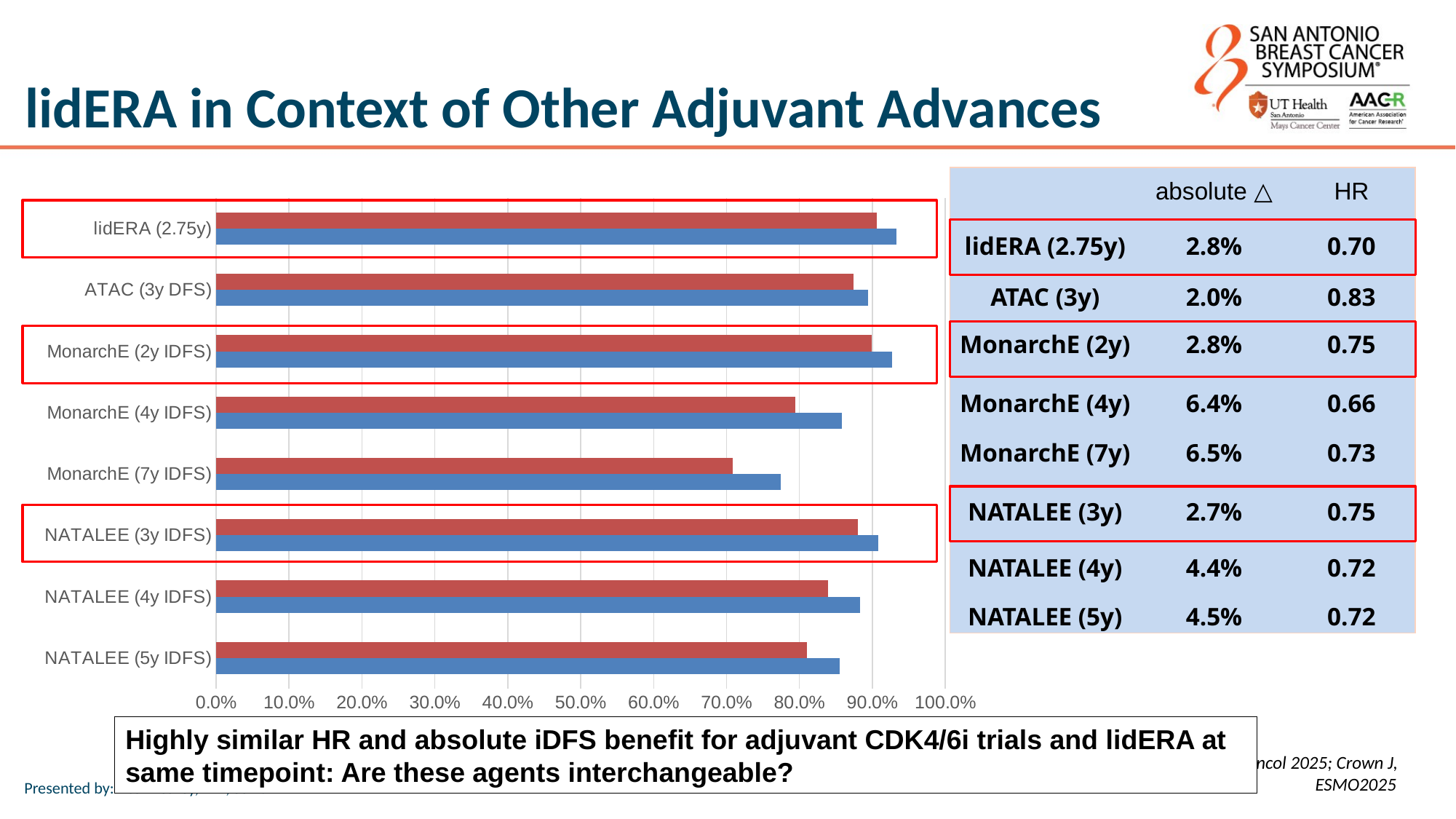
How many categories (trial/timepoint labels) are plotted on the chart? 8 Is the red bar for MonarchE (7y IDFS) greater or less than 80.0%? less Which has the larger blue bar: MonarchE (7y IDFS) or NATALEE (5y IDFS)? NATALEE (5y IDFS) Which category has the lowest blue bar on the chart? MonarchE (7y IDFS) How many bars are plotted for each category on the chart? 2 Is the red bar for NATALEE (5y IDFS) greater or less than 90.0%? less Is the blue bar for MonarchE (4y IDFS) greater or less than 80.0%? greater Which category has the lowest red bar on the chart? MonarchE (7y IDFS) What is the title of the slide containing the chart? lidERA in Context of Other Adjuvant Advances What kind of chart is shown on the slide? bar chart Which has the larger red bar: MonarchE (4y IDFS) or NATALEE (4y IDFS)? NATALEE (4y IDFS)